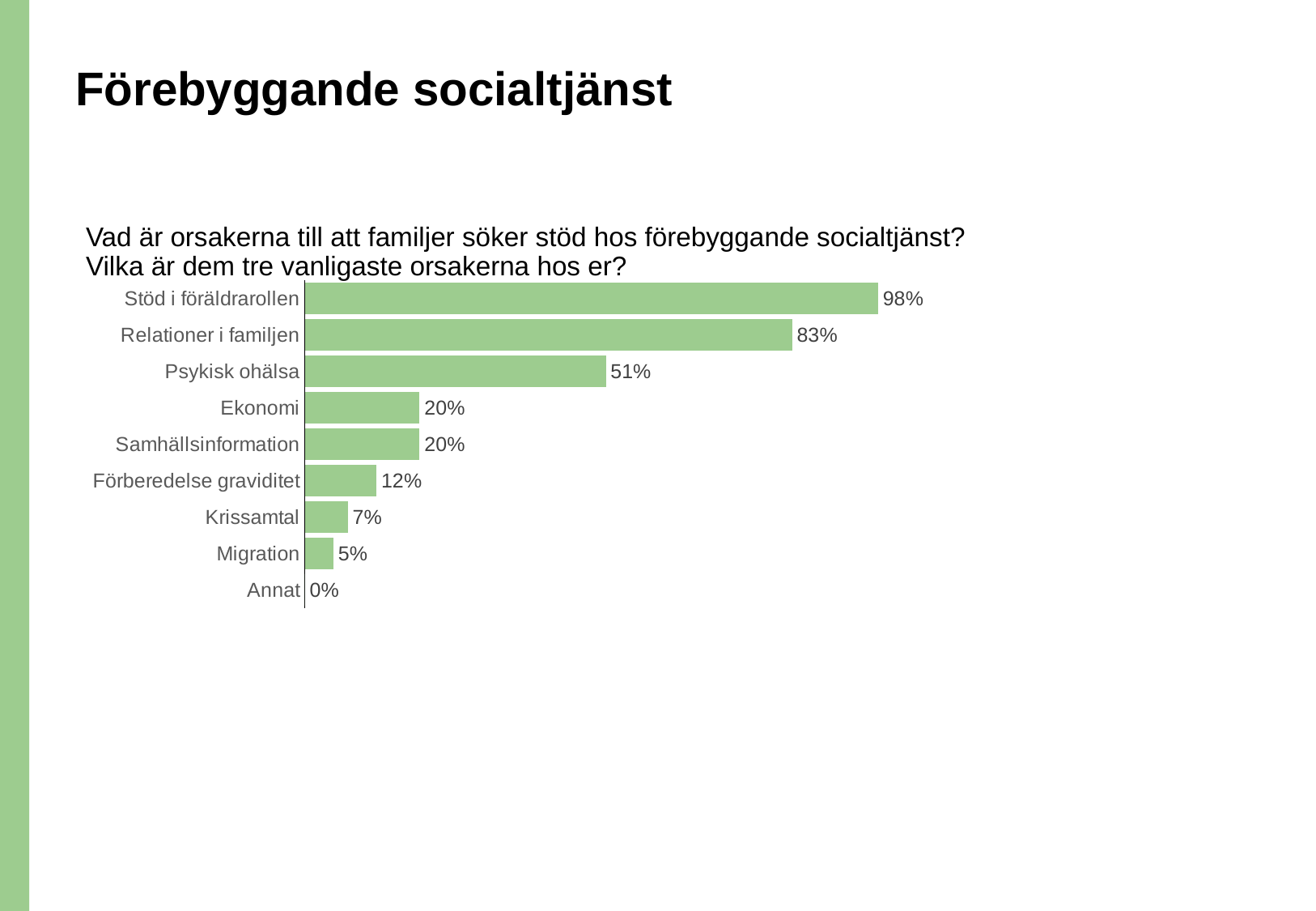
Which category has the highest value? Stöd i föräldrarollen What is the difference between Stöd i föräldrarollen and Relationer i familjen? 15% What is the value for Psykisk ohälsa? 51% What is the value for Migration? 5% How many categories are shown in the chart? 9 Which category has the lowest value? Annat Which two categories share the same value of 20%? Ekonomi and Samhällsinformation What kind of chart is shown on the slide? Bar chart What is the value for Förberedelse graviditet? 12% Which is larger, Krissamtal or Migration? Krissamtal What is the value for Stöd i föräldrarollen? 98% What is the difference between Psykisk ohälsa and Ekonomi? 31%